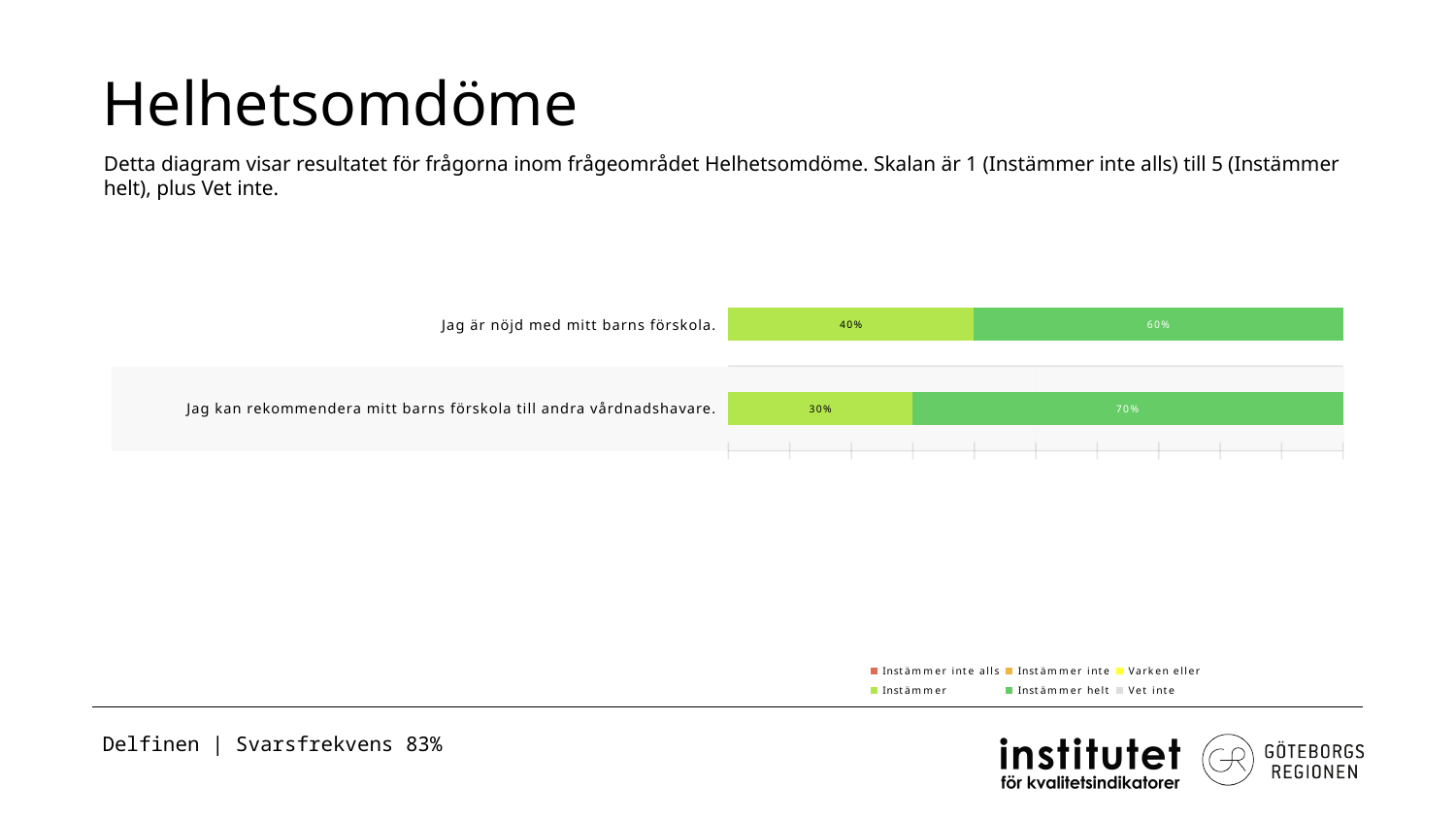
Which statement has the higher share of "Instämmer helt" responses? Jag kan rekommendera mitt barns förskola till andra vårdnadshavare. How many response options does the legend list? 6 For "Jag är nöjd med mitt barns förskola.", which is larger: the "Instämmer" share or the "Instämmer helt" share? Instämmer helt What is the difference between the "Instämmer helt" shares of the two statements? 10% What share of respondents answered "Instämmer" for "Jag är nöjd med mitt barns förskola."? 40% What type of chart is shown on the slide? Stacked bar chart How many statements (categories) are shown in the chart? 2 What share of respondents answered "Instämmer helt" for "Jag är nöjd med mitt barns förskola."? 60% What share of respondents answered "Instämmer helt" for "Jag kan rekommendera mitt barns förskola till andra vårdnadshavare."? 70% What share of respondents answered "Instämmer" for "Jag kan rekommendera mitt barns förskola till andra vårdnadshavare."? 30% What is the combined share of "Instämmer" and "Instämmer helt" for "Jag kan rekommendera mitt barns förskola till andra vårdnadshavare."? 100% Which statement has the lower share of "Instämmer" responses? Jag kan rekommendera mitt barns förskola till andra vårdnadshavare.